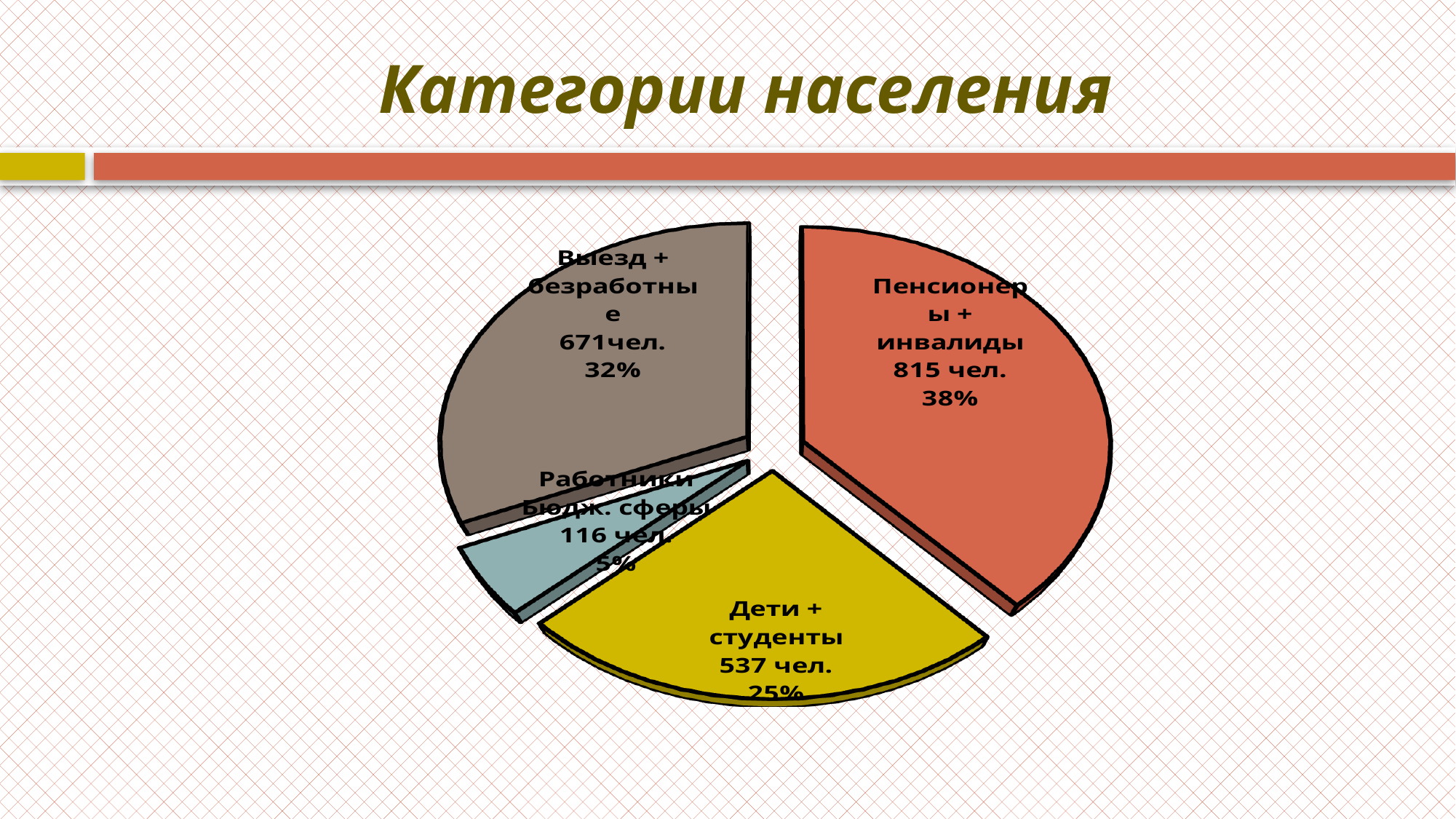
What is the difference in people between "Пенсионеры + инвалиды" and "Дети + студенты"? 278 чел. Which category has the smallest slice of the pie? Работники бюдж. сферы How many people are in the category "Работники бюдж. сферы"? 116 чел. What share of the pie does "Пенсионеры + инвалиды" represent? 38% How many slices does the pie chart have? 4 What is the title of the slide containing the pie chart? Категории населения What share of the pie does "Работники бюдж. сферы" represent? 5% How many people are in the category "Выезд + безработные"? 671 чел. What kind of chart is shown on the slide? pie chart How many people are in the category "Пенсионеры + инвалиды"? 815 чел. How many people are in the category "Дети + студенты"? 537 чел. Which category has the largest slice of the pie? Пенсионеры + инвалиды